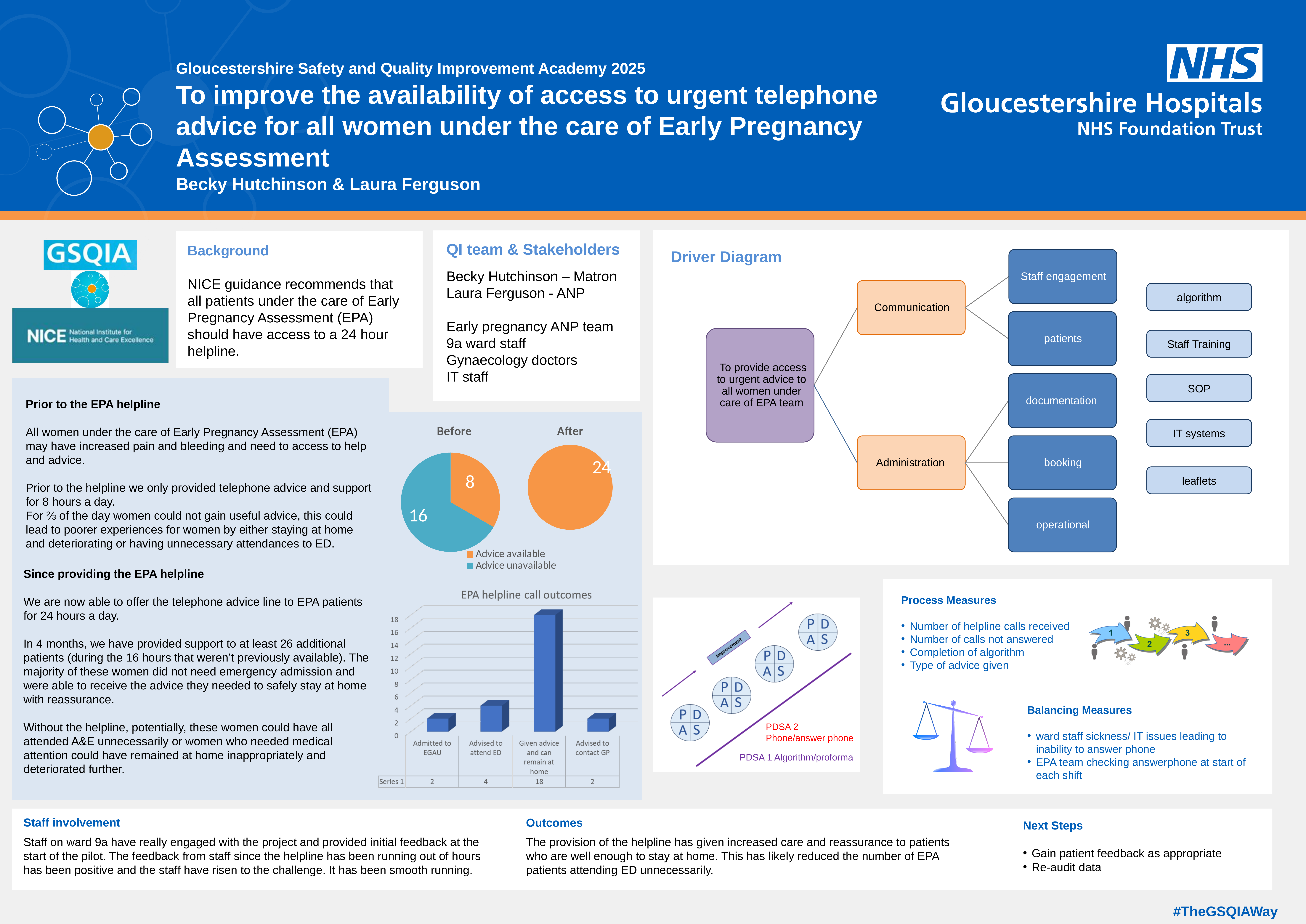
What is the total of all values in the 'EPA helpline call outcomes' chart? 26 In the 'Before' pie chart, what is the value for Advice unavailable? 16 In the 'EPA helpline call outcomes' chart, what is the value for Advised to attend ED? 4 In the 'EPA helpline call outcomes' chart, which category has the highest value? Given advice and can remain at home In the 'Before' pie chart, what share of the pie is Advice unavailable? 2/3 How many categories are shown in the 'EPA helpline call outcomes' chart? 4 In the 'After' pie chart, what value is shown for Advice available? 24 In the 'EPA helpline call outcomes' chart, what is the difference between Given advice and can remain at home and Advised to attend ED? 14 What kind of chart is 'EPA helpline call outcomes'? Bar chart In the 'EPA helpline call outcomes' chart, what is the value for Given advice and can remain at home? 18 In the 'Before' pie chart, which category is larger, Advice available or Advice unavailable? Advice unavailable In the 'Before' pie chart, what is the value for Advice available? 8